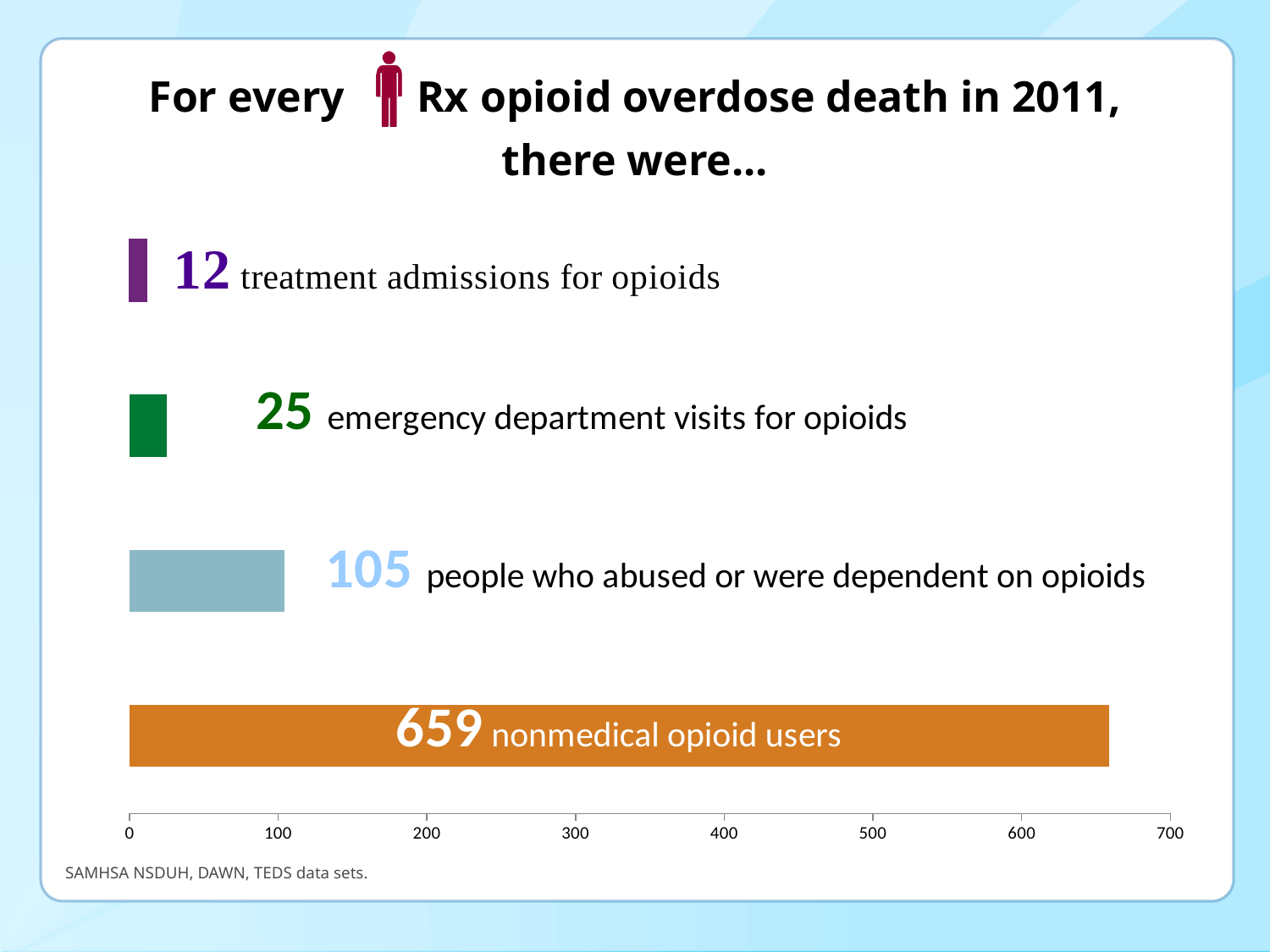
What is the value for nonmedical opioid users? 659 Which is larger: emergency department visits for opioids or treatment admissions for opioids? emergency department visits for opioids Is the value for nonmedical opioid users greater or less than 600? greater What kind of chart is shown on the slide? bar chart What is the value for treatment admissions for opioids? 12 What is the highest value shown on the x axis? 700 Which category has the lowest value? treatment admissions for opioids What is the difference between the value for nonmedical opioid users and the value for people who abused or were dependent on opioids? 554 What is the value for emergency department visits for opioids? 25 How many bars does the chart show? 4 What is the value for people who abused or were dependent on opioids? 105 Which category has the highest value? nonmedical opioid users